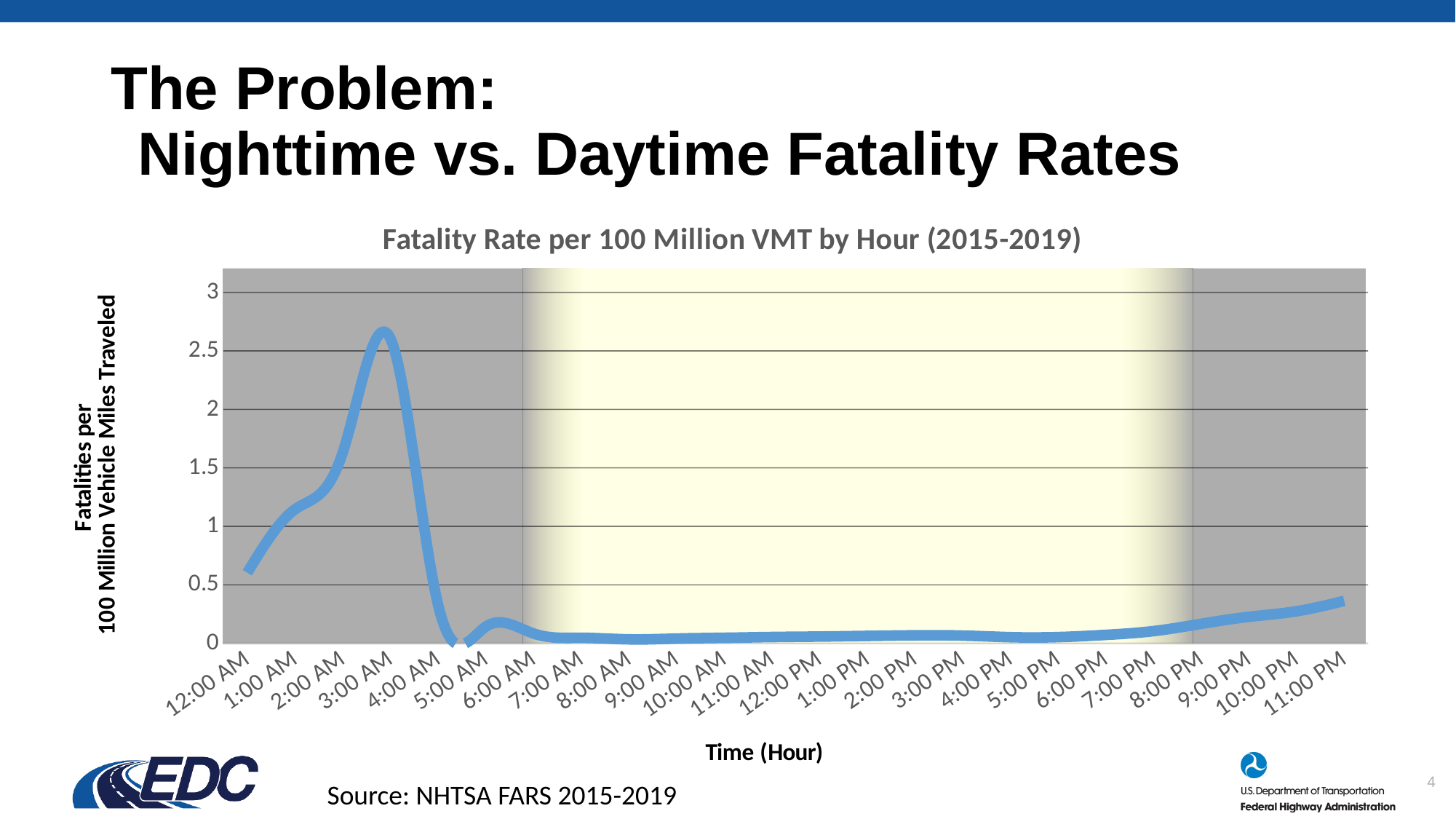
What is the label of the x axis? Time (Hour) Which hour has the larger fatality rate, 1:00 AM or 1:00 PM? 1:00 AM Is the value at 3:00 AM greater or less than 2.5? greater What is the title of the chart? Fatality Rate per 100 Million VMT by Hour (2015-2019) Is the value at 2:00 AM greater or less than 1? greater What kind of chart is shown on the slide? line chart Is the value at 12:00 PM greater or less than 0.5? less How many hourly points are plotted along the x axis? 24 Which hour has the larger fatality rate, 11:00 PM or 3:00 PM? 11:00 PM Does the fatality rate rise or fall between 3:00 AM and 5:00 AM? fall At which hour is the fatality rate highest? 3:00 AM